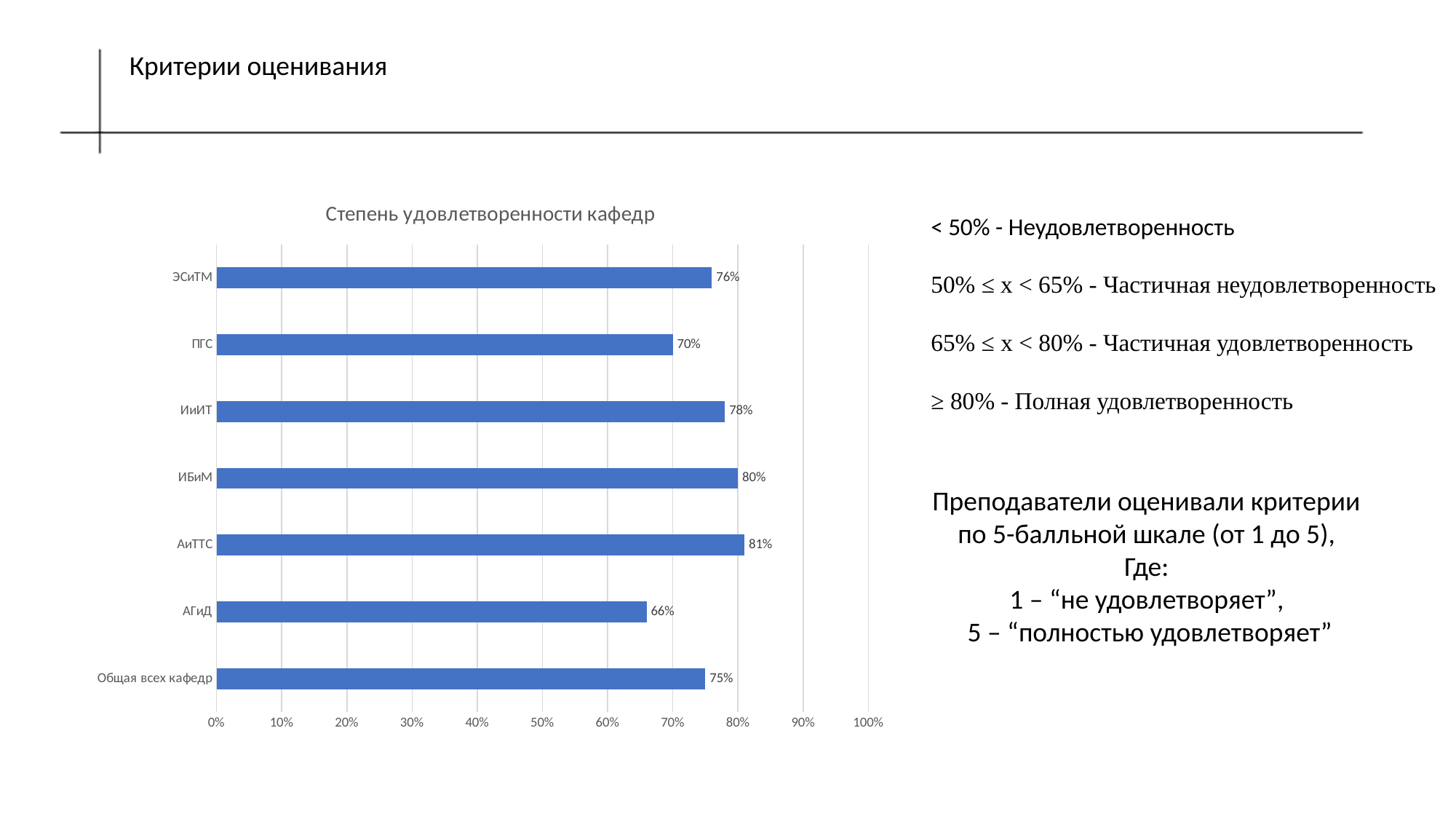
How many categories are shown in the chart? 7 What is the value for Общая всех кафедр? 75% Which category has the highest value? АиТТС What is the value for ПГС? 70% Is the value for АГиД greater or less than 70%? less Which is larger, the value for ИиИТ or the value for ПГС? ИиИТ What is the value for ЭСиТМ? 76% What is the value for АиТТС? 81% Which category has the lowest value? АГиД What is the difference between the values for ИБиМ and АГиД? 14% What kind of chart is shown on the slide? bar chart What is the title of the chart? Степень удовлетворенности кафедр